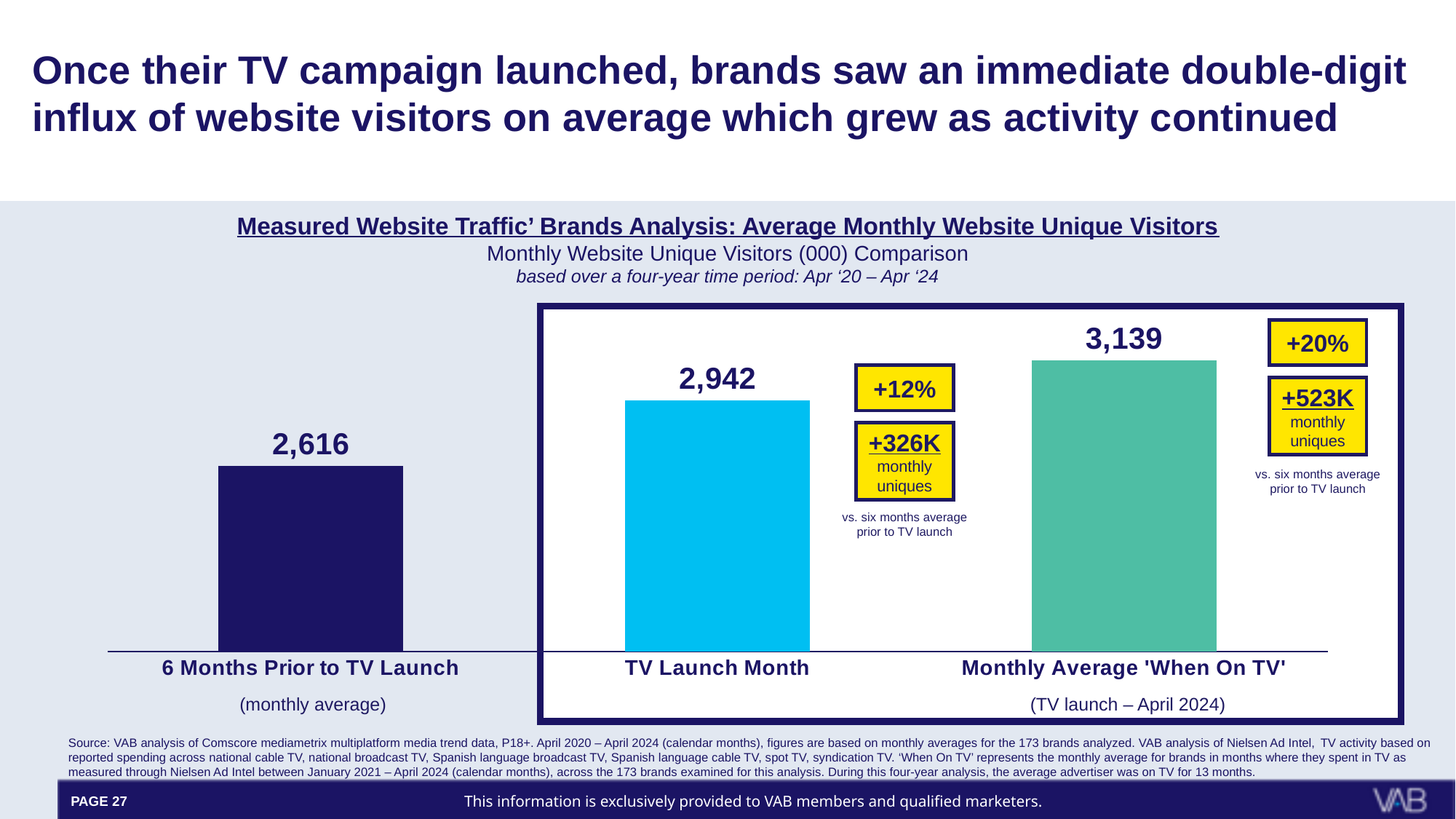
Do the values rise or fall from left to right across the categories? Rise Which category has the lowest value? 6 Months Prior to TV Launch Which is larger, the value for TV Launch Month or the value for Monthly Average 'When On TV'? Monthly Average 'When On TV' What is the value for TV Launch Month? 2,942 What is the difference between the Monthly Average 'When On TV' value and the 6 Months Prior to TV Launch value? 523 What is the value for Monthly Average 'When On TV'? 3,139 How many categories are shown in the chart? 3 What is the value for 6 Months Prior to TV Launch? 2,616 What is the difference between the TV Launch Month value and the 6 Months Prior to TV Launch value? 326 What kind of chart is shown on the slide? Bar chart What percentage increase is shown for the TV Launch Month versus the six months average prior to TV launch? +12% Which category has the highest value? Monthly Average 'When On TV'